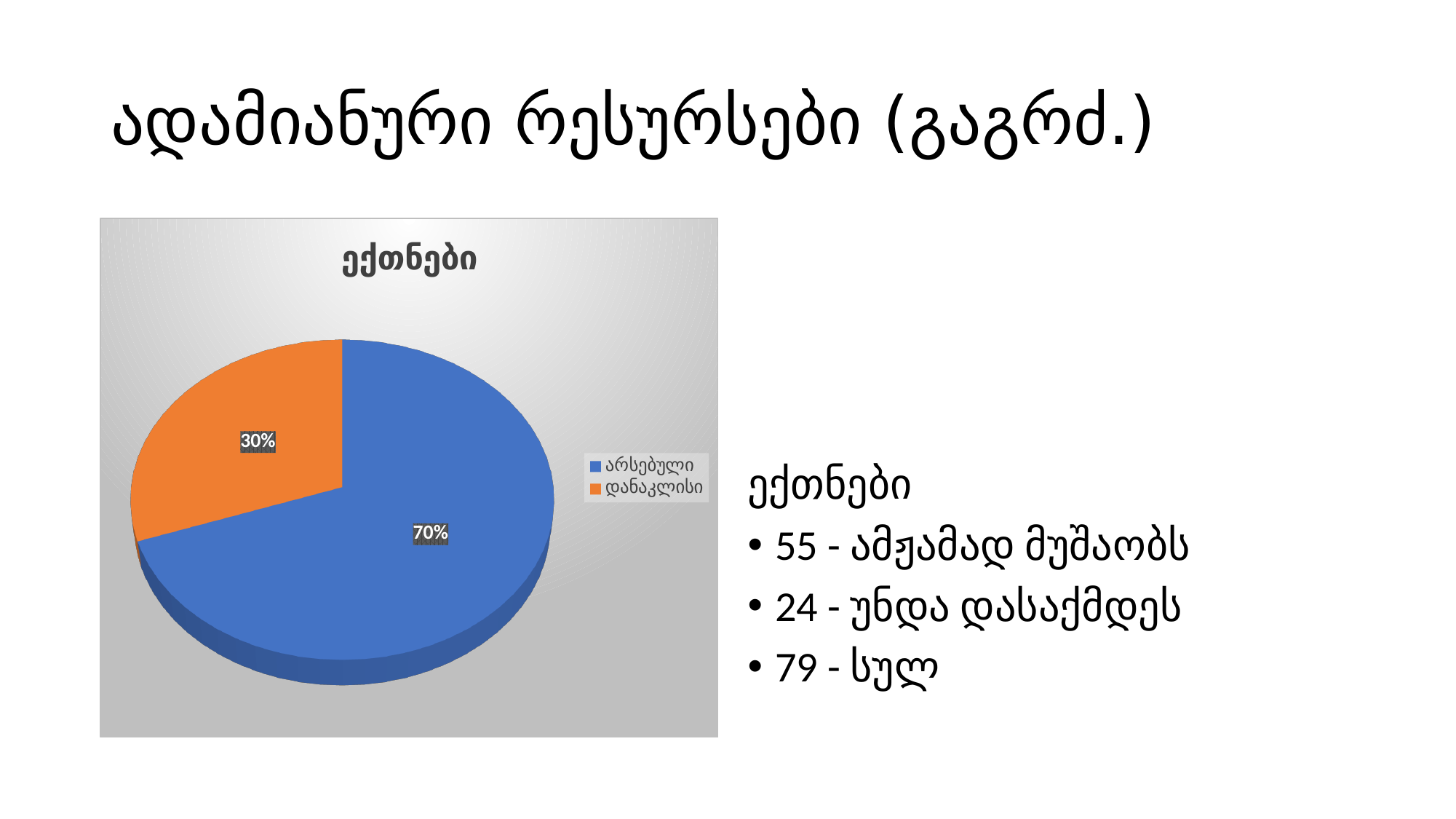
What share of the pie does the slice for არსებული represent? 70% Which is larger, the slice for არსებული or the slice for დანაკლისი? არსებული How many slices does the pie chart have? 2 What is the difference in percentage points between the არსებული slice and the დანაკლისი slice? 40% Which slice of the pie is the largest? არსებული What share of the pie does the slice for დანაკლისი represent? 30% What is the title of the chart? ექთნები What colour is the slice for დანაკლისი? orange How many entries does the legend list? 2 Which slice of the pie is the smallest? დანაკლისი What kind of chart is shown on the slide? pie chart